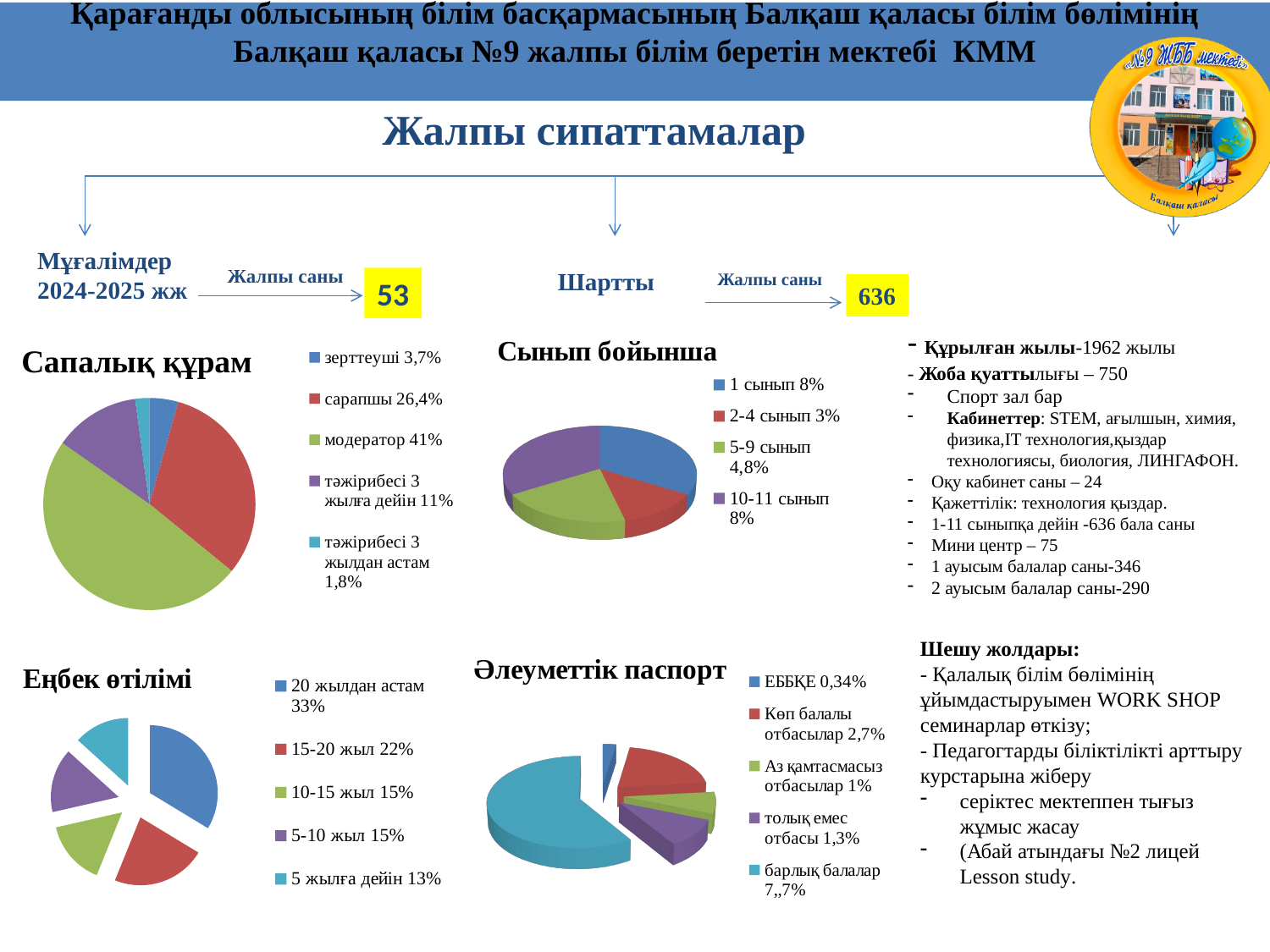
In the "Сынып бойынша" chart, what percentage is shown for 5-9 сынып? 4,8% In the "Сапалық құрам" chart, what is the difference between the сарапшы share and the зерттеуші share? 22,7% How many categories does the "Сапалық құрам" chart's legend list? 5 What type of chart is the "Сынып бойынша" chart? pie chart In the "Сапалық құрам" chart, which category has the smallest share? тәжірибесі 3 жылдан астам In the "Еңбек өтілімі" chart, which is larger: 5-10 жыл or 5 жылға дейін? 5-10 жыл In the "Әлеуметтік паспорт" chart, what percentage is shown for Көп балалы отбасылар? 2,7% In the "Сапалық құрам" chart, what percentage is shown for модератор? 41% In the "Әлеуметтік паспорт" chart, which category has the smallest percentage? ЕББҚЕ In the "Сынып бойынша" chart, which category has the lowest percentage? 2-4 сынып In the "Еңбек өтілімі" chart, which category has the largest share? 20 жылдан астам In the "Еңбек өтілімі" chart, what percentage is shown for 15-20 жыл? 22%